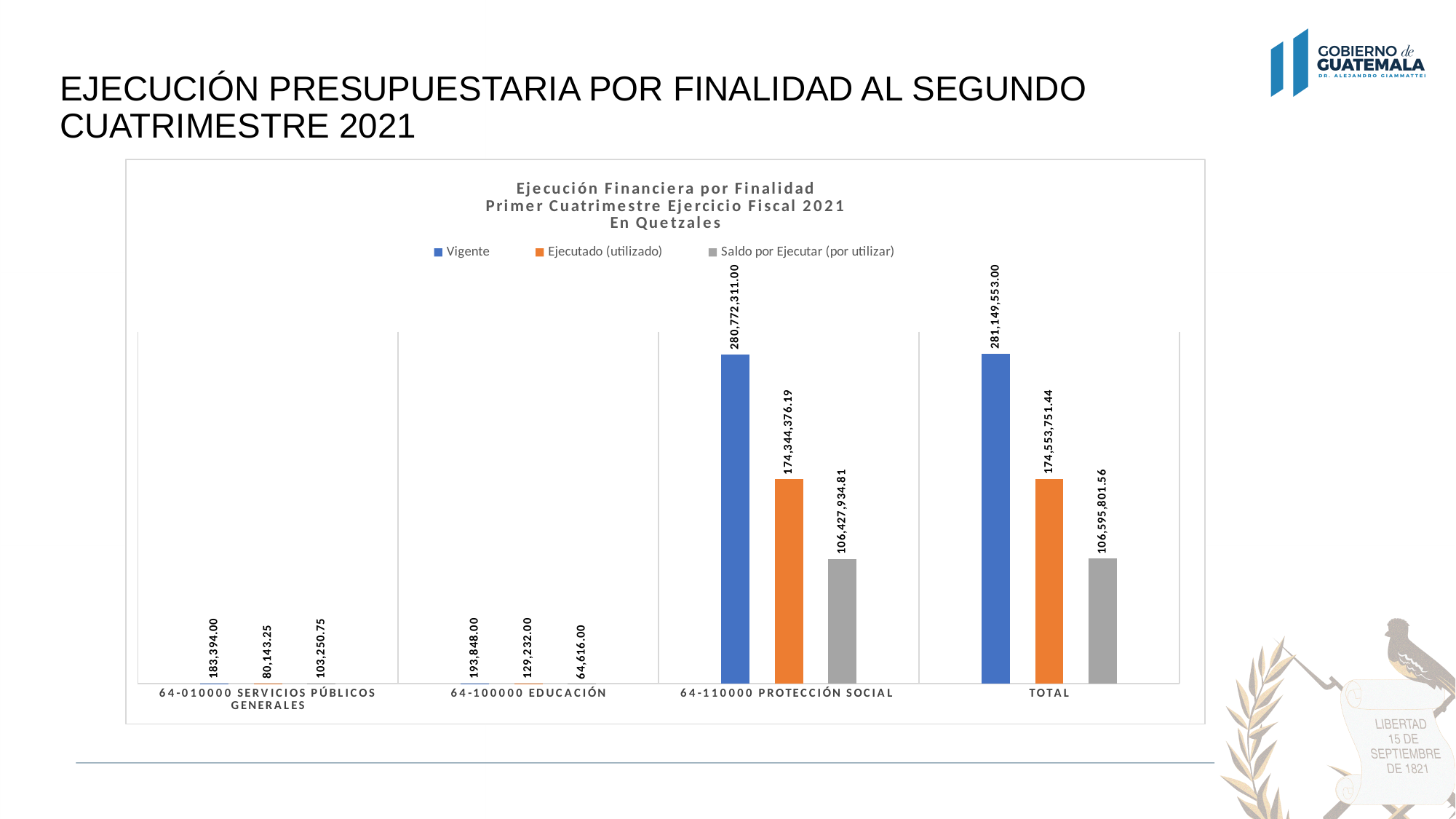
How many series does the chart legend list? 3 What type of chart is shown on the slide? Bar chart Which series is shown in orange in the chart legend? Ejecutado (utilizado) What is the Ejecutado (utilizado) value for Total? 174,553,751.44 How many categories are shown on the x axis of the chart? 4 What is the Saldo por Ejecutar (por utilizar) value for 64-010000 Servicios Públicos Generales? 103,250.75 Which is larger for 64-110000 Protección Social: the Ejecutado (utilizado) value or the Saldo por Ejecutar (por utilizar) value? Ejecutado (utilizado) What is the difference between the Vigente and Ejecutado (utilizado) values for 64-100000 Educación? 64,616.00 Which category has the highest Vigente value? Total What is the Vigente value for 64-110000 Protección Social? 280,772,311.00 Which category has the lowest Vigente value? 64-010000 Servicios Públicos Generales What is the Ejecutado (utilizado) value for 64-100000 Educación? 129,232.00